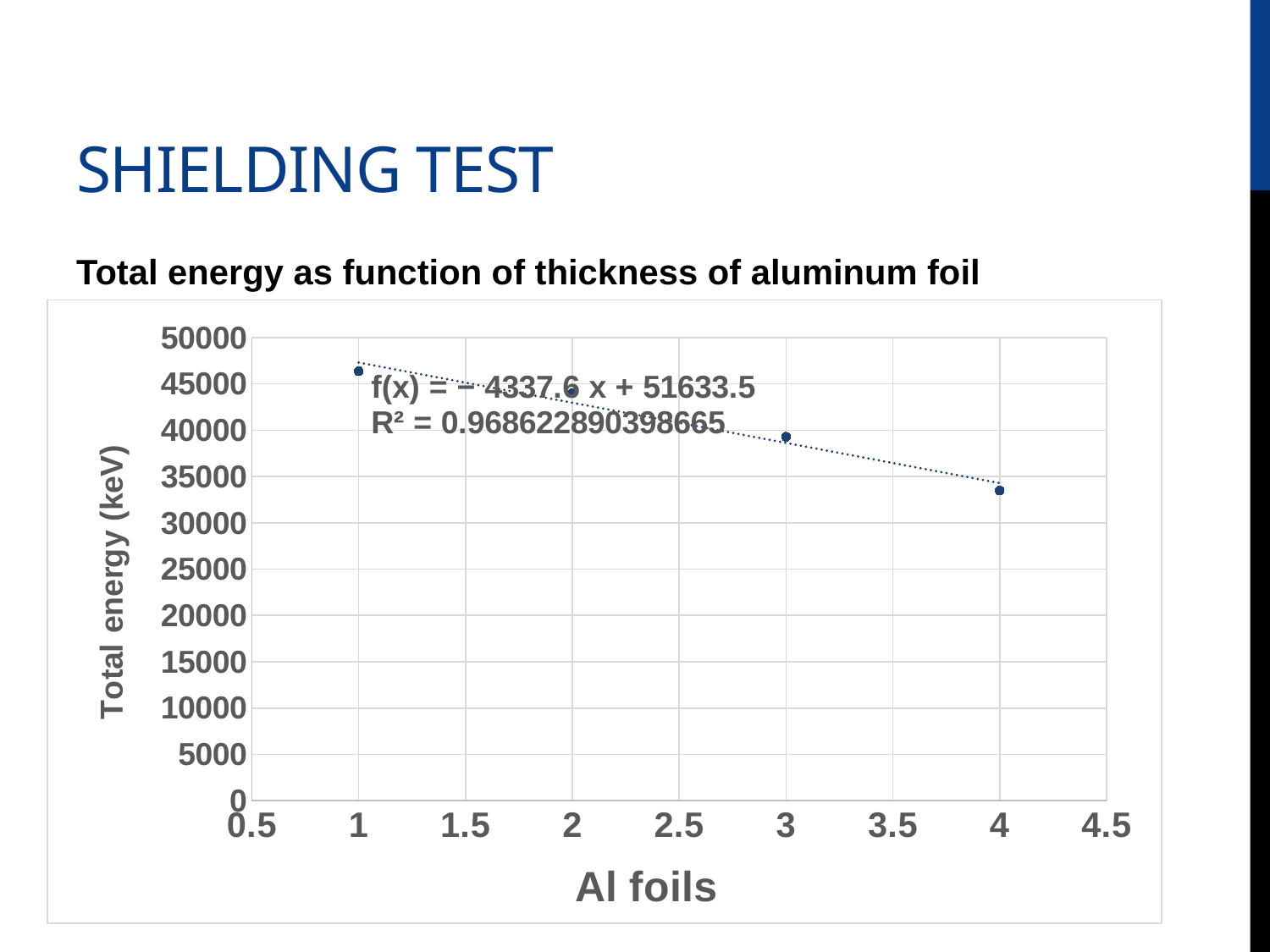
Is the total energy for 1 Al foil greater or less than 45000 keV? greater What is the trendline equation printed on the chart? f(x) = − 4337.6 x + 51633.5 At which number of Al foils is the total energy lowest? 4 What kind of chart is shown on the slide? scatter chart Which has a larger total energy: 2 Al foils or 3 Al foils? 2 Al foils What is the title of the chart? Total energy as function of thickness of aluminum foil At which number of Al foils is the total energy highest? 1 Is the total energy for 4 Al foils greater or less than 35000 keV? less How many data points are plotted in the chart? 4 Is the total energy for 3 Al foils greater or less than 40000 keV? less Do the total energy values rise or fall as the number of Al foils increases? fall